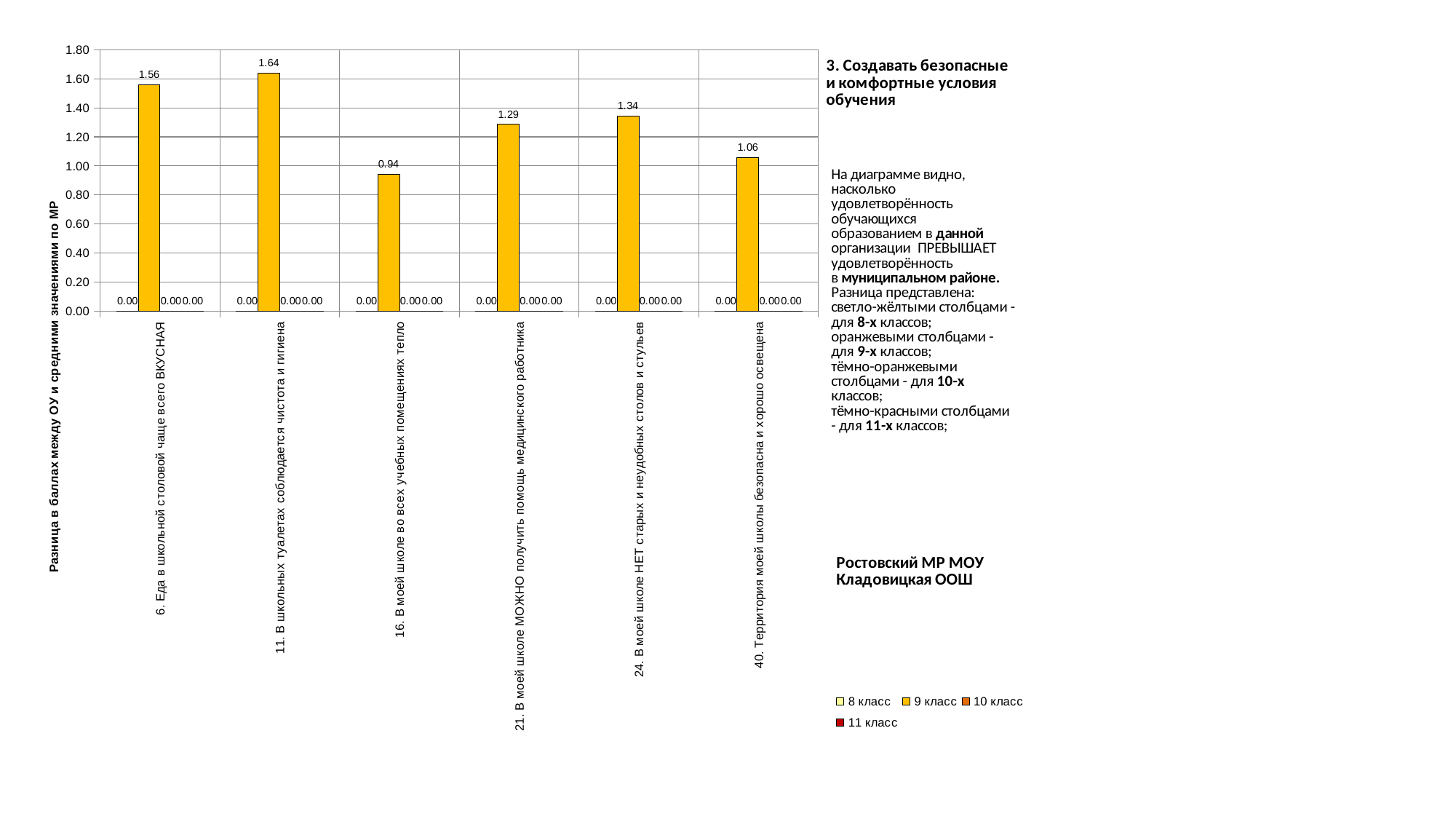
What kind of chart is shown on the slide? bar chart What is the difference between the "9 класс" values for category 11 (1.64) and category 16 (0.94)? 0.70 How many categories are shown on the x axis of the chart? 6 How many series does the chart legend list? 4 What is the value for "9 класс" for category "40. Территория моей школы безопасна и хорошо освещена"? 1.06 What is the value for "9 класс" for category "16. В моей школе во всех учебных помещениях тепло"? 0.94 What is the value for "8 класс" for category "6. Еда в школьной столовой чаще всего ВКУСНАЯ"? 0.00 Which category has the highest value for "9 класс"? 11. В школьных туалетах соблюдается чистота и гигиена Which category has the lowest value for "9 класс"? 16. В моей школе во всех учебных помещениях тепло What is the label of the vertical axis of the chart? Разница в баллах между ОУ и средними значениями по МР Which is larger for "9 класс": the value for category 21 (медицинского работника) or category 24 (старых и неудобных столов и стульев)? 24. В моей школе НЕТ старых и неудобных столов и стульев What is the value for "9 класс" for category "6. Еда в школьной столовой чаще всего ВКУСНАЯ"? 1.56